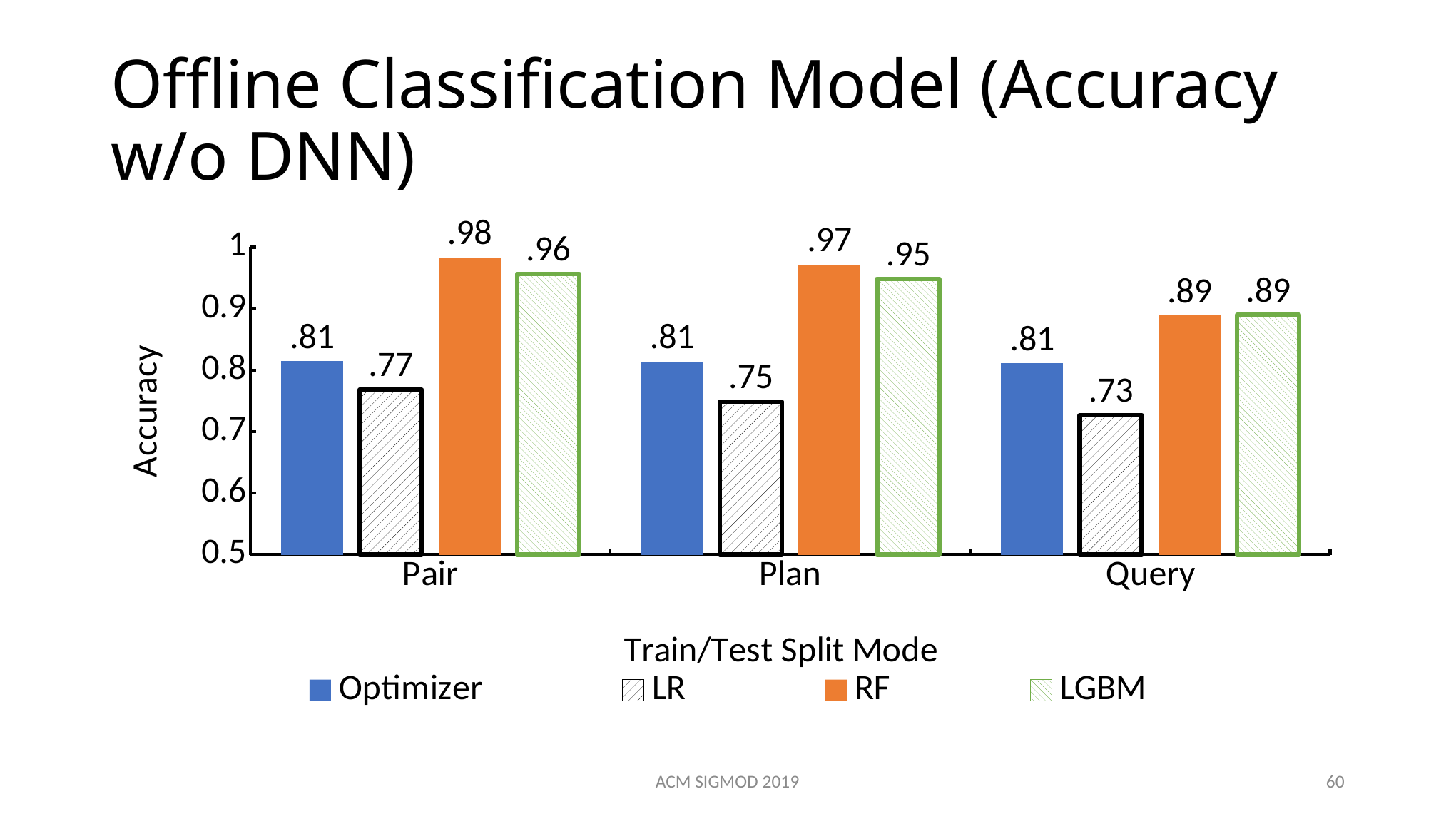
What kind of chart is shown on the slide? bar chart What is the accuracy of RF in the Pair split mode? .98 What is the accuracy of LR in the Query split mode? .73 Which is larger, the Optimizer accuracy or the LR accuracy in the Plan split mode? Optimizer How many series does the legend list? 4 What is the accuracy of LGBM in the Plan split mode? .95 Which series has the lowest accuracy in the Query split mode? LR Which series has the highest accuracy in the Plan split mode? RF How many train/test split modes are shown on the x axis? 3 Is the LR accuracy in the Query split mode greater or less than 0.8? less What is the label of the y axis? Accuracy What is the difference between the RF and LR accuracies in the Pair split mode? .21